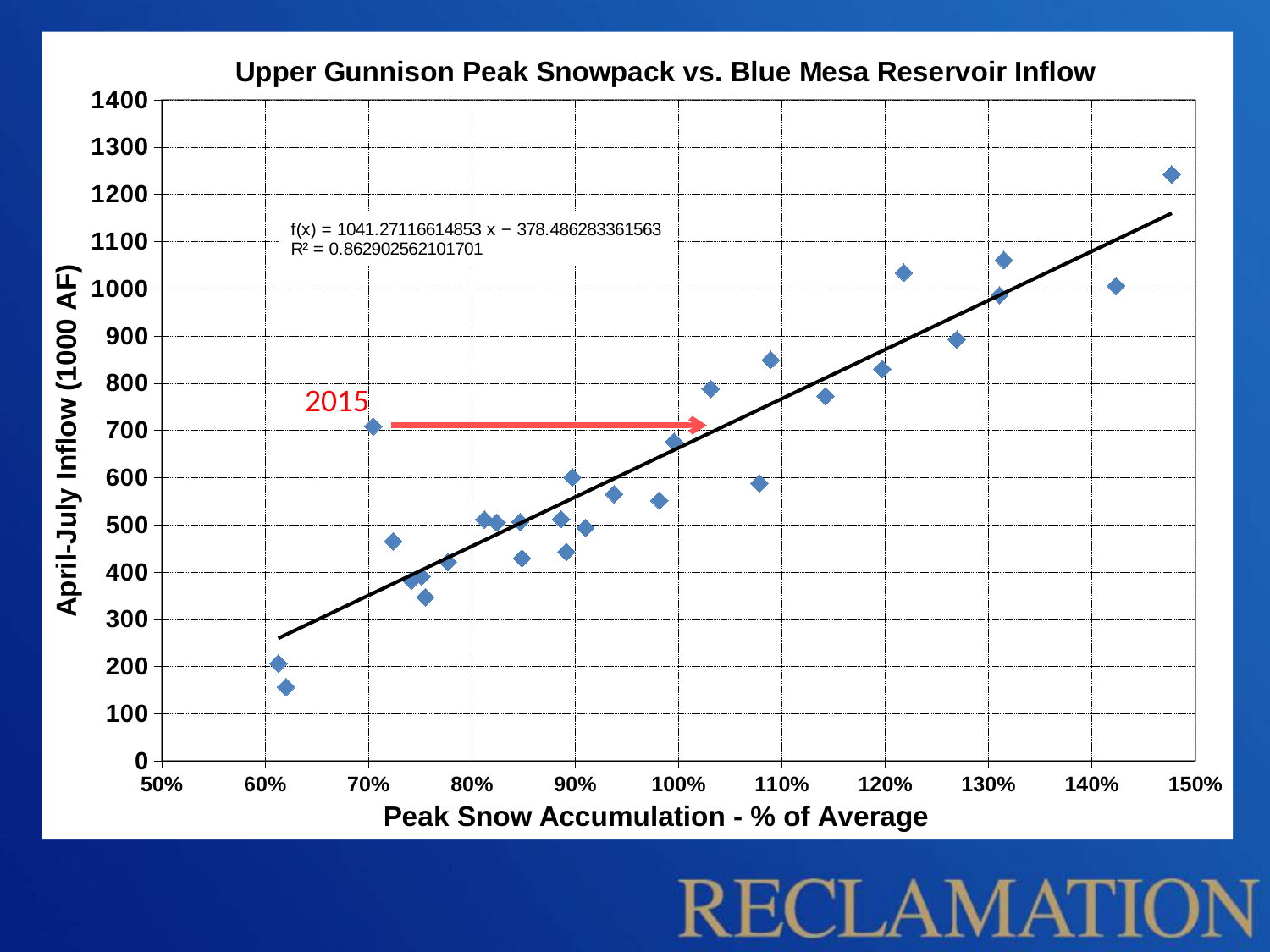
Which year is labelled with a red annotation on the chart? 2015 What R² value is printed on the chart? 0.862902562101701 What is the lowest value shown on the horizontal axis? 50% What kind of chart is shown on the slide? Scatter chart Is the inflow value of the point plotted near 122% snow accumulation greater or less than 1000? greater Is the inflow value of the highest plotted point greater or less than 1200? greater What is the label of the vertical axis? April-July Inflow (1000 AF) What is the title of the chart? Upper Gunnison Peak Snowpack vs. Blue Mesa Reservoir Inflow As peak snow accumulation increases along the x axis, do the inflow values generally rise or fall? Rise Are the inflow values of the points plotted near 61% snow accumulation greater or less than 300? less What is the maximum value shown on the vertical axis? 1400 What is the slope coefficient in the trendline equation printed on the chart? 1041.27116614853